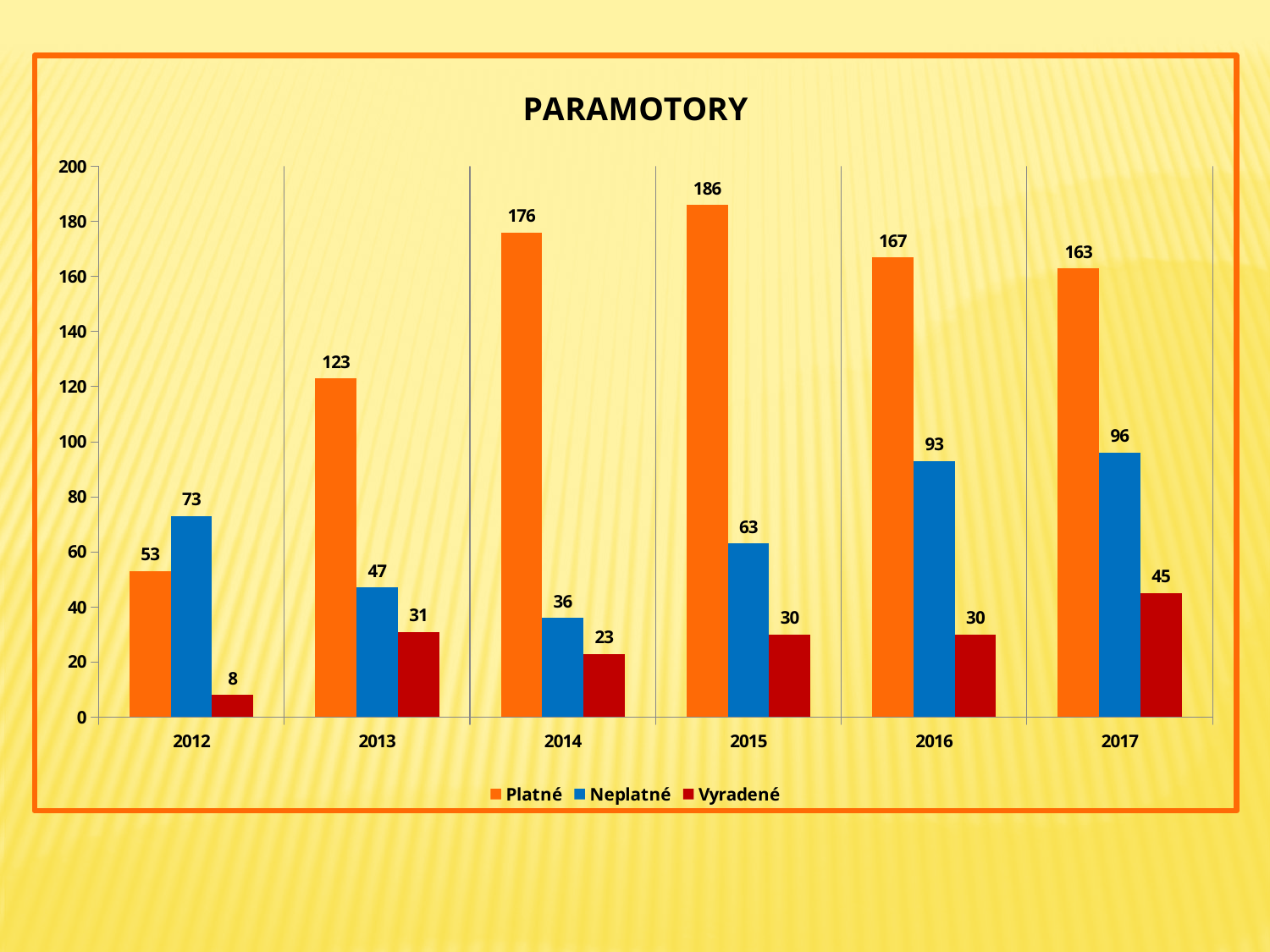
Is the Neplatné value for 2016 greater or less than 80? greater Which year has the lowest Vyradené value? 2012 What is the title of the chart? PARAMOTORY How many years are shown on the x axis? 6 How many series does the legend list? 3 What is the Vyradené value for 2017? 45 What is the difference between the Platné values for 2014 and 2013? 53 Which is larger in 2012, Platné or Neplatné? Neplatné What is the Neplatné value for 2013? 47 What kind of chart is shown? bar chart What is the Platné value for 2015? 186 Which year has the highest Platné value? 2015